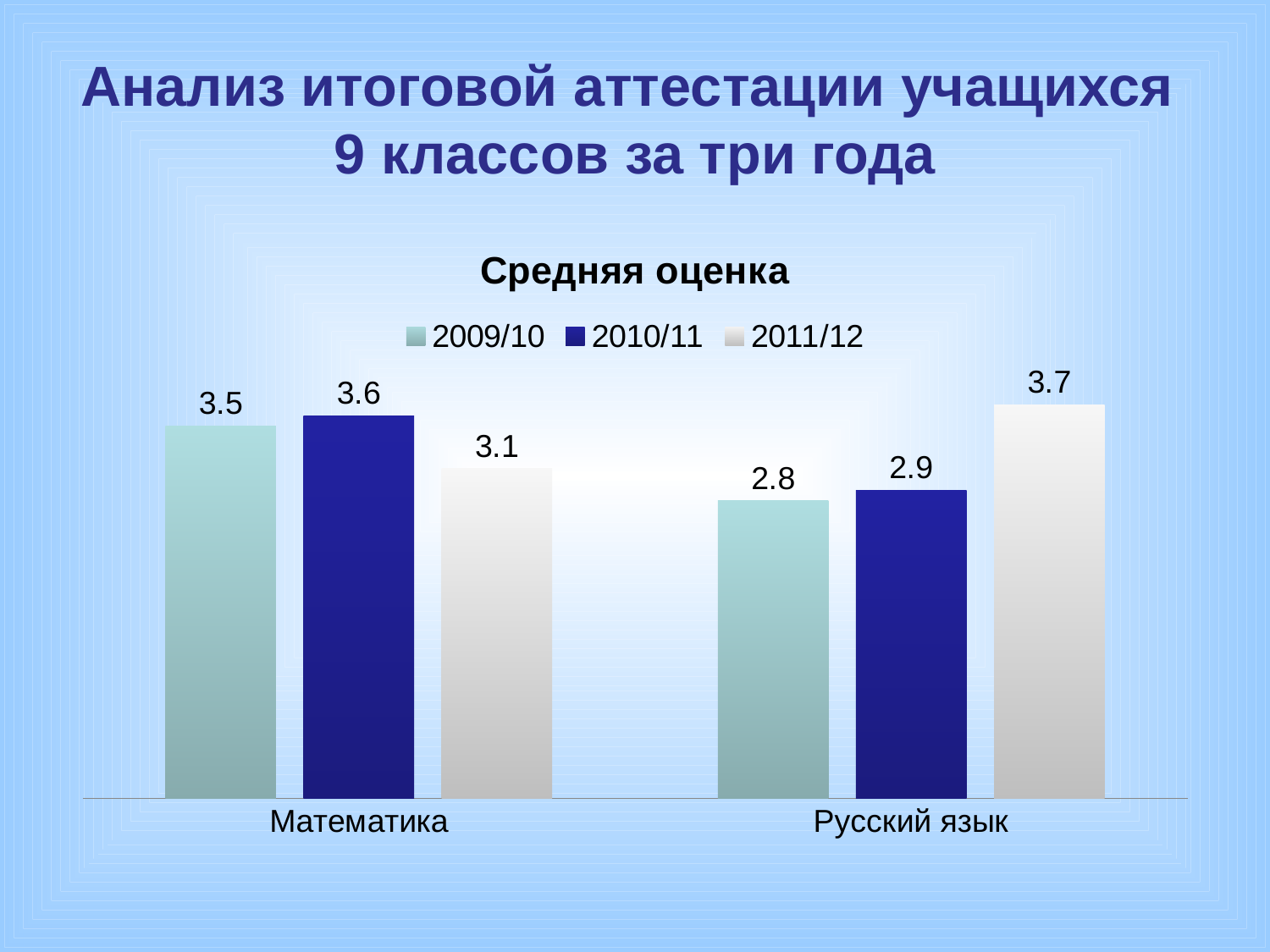
What is the value for Математика in the 2011/12 series? 3.1 What is the difference between the 2011/12 values for Русский язык and Математика? 0.6 What kind of chart is shown on the slide? bar chart Which series has the lowest value for Русский язык? 2009/10 What is the value for Математика in the 2009/10 series? 3.5 What is the value for Русский язык in the 2011/12 series? 3.7 What is the value for Русский язык in the 2009/10 series? 2.8 Which is larger: the 2010/11 value for Математика or the 2010/11 value for Русский язык? Математика Which series has the highest value for Математика? 2010/11 What is the title of the chart? Средняя оценка How many series does the legend list? 3 How many categories are shown on the x axis? 2